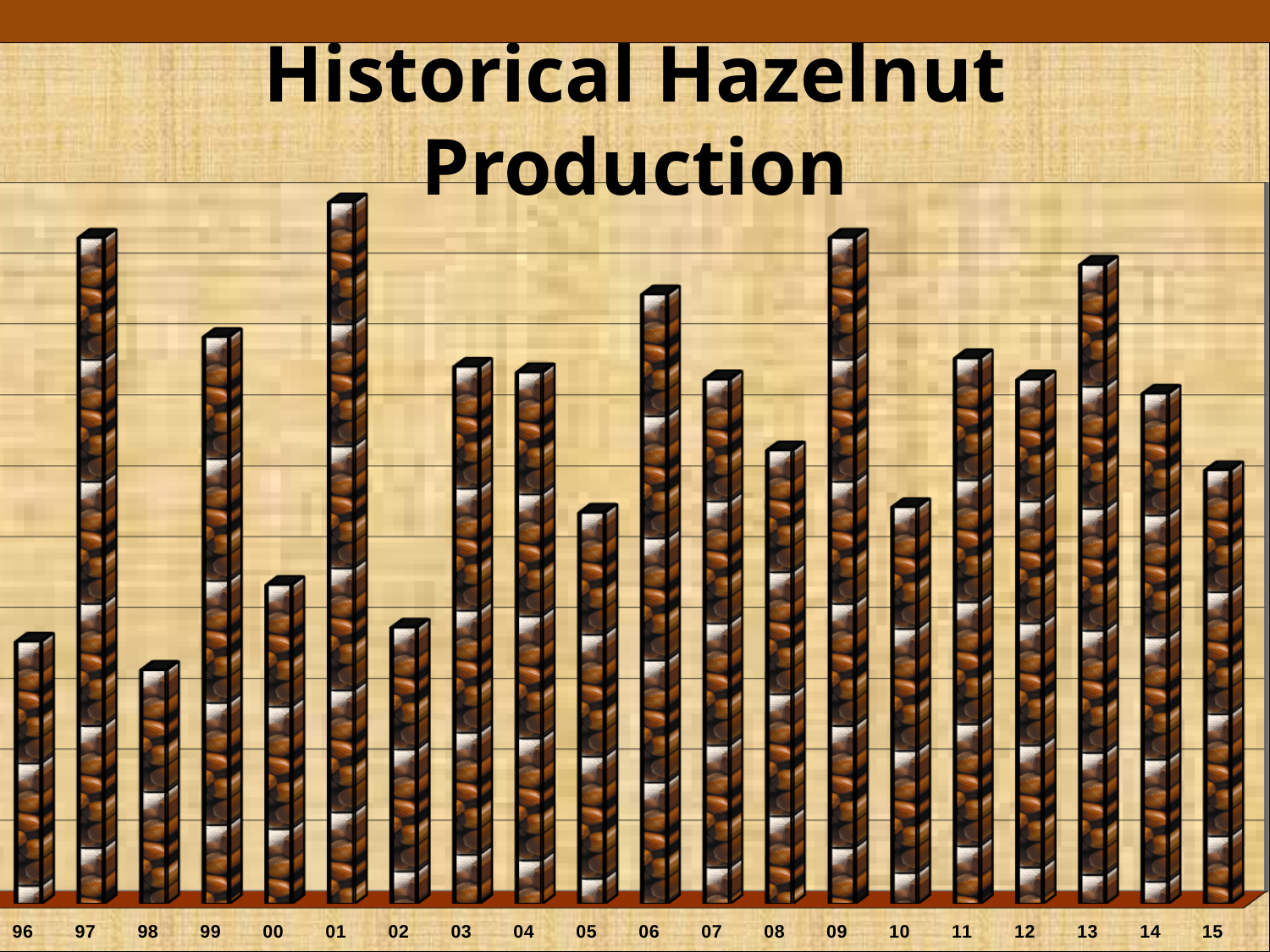
What is the title of the chart? Historical Hazelnut Production Which year has higher production, 00 or 02? 00 What is the first year shown on the x axis? 96 Which year has higher production, 08 or 14? 14 Which year has the lowest hazelnut production? 98 Which year has the highest hazelnut production? 01 Which year has higher production, 06 or 13? 13 What kind of chart is shown on the slide? bar chart How many years (categories) are shown on the x axis? 20 From 13 to 15, do the values rise or fall? fall